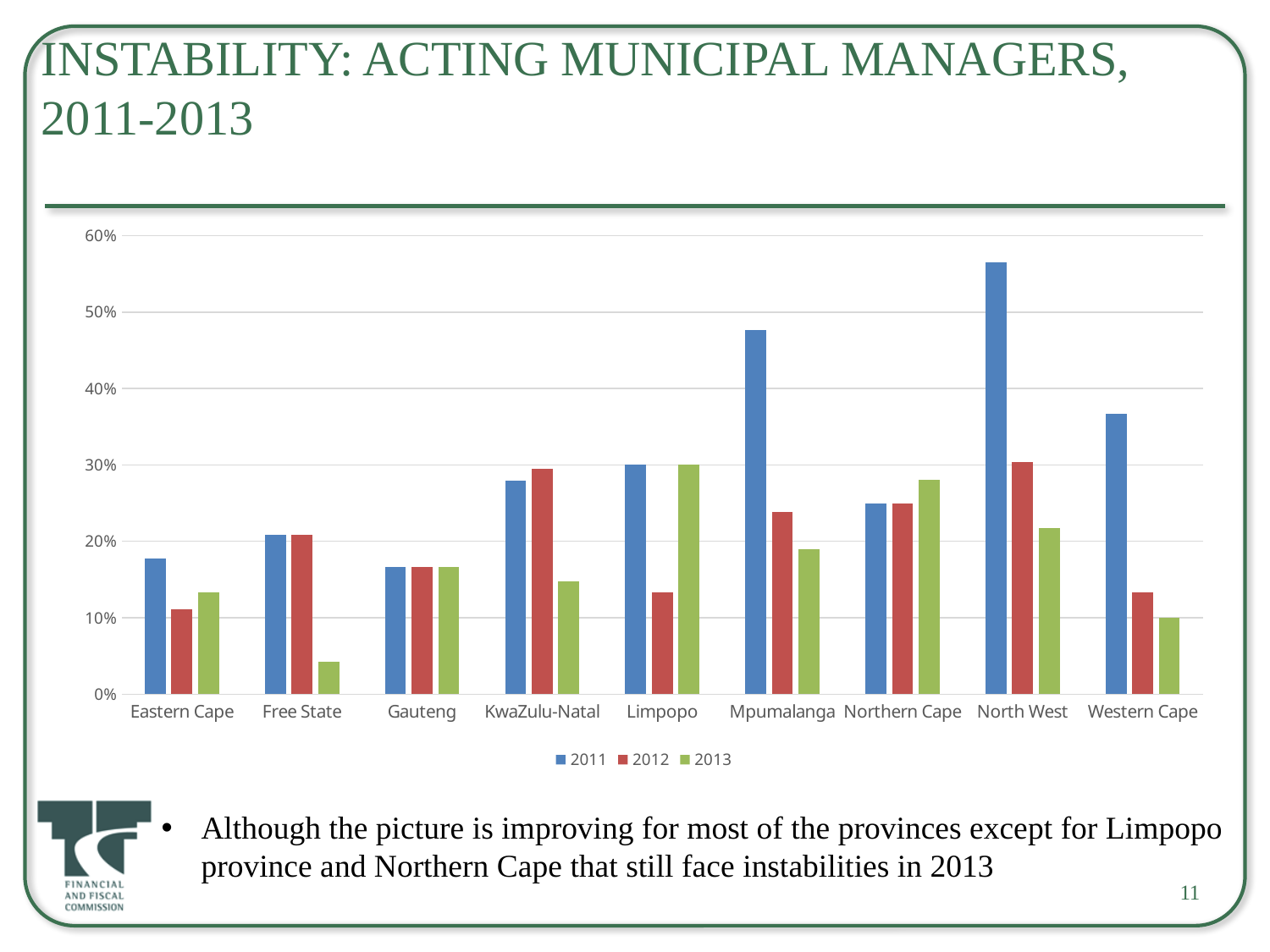
How many provinces are shown on the x axis? 9 How many series does the legend list? 3 For Limpopo, which year has the larger value: 2012 or 2013? 2013 Is the 2011 value for Mpumalanga greater or less than 40%? greater What kind of chart is shown on the slide? Bar chart Is the 2011 value for North West greater or less than 50%? greater What are the legend entries of the chart? 2011, 2012, 2013 Do the values for Western Cape rise or fall from 2011 to 2013? fall Which province has the lowest value for 2013? Free State Is the 2013 value for Free State greater or less than 10%? less Which province has the highest value for 2011? North West Which is larger for 2011: Mpumalanga or Western Cape? Mpumalanga